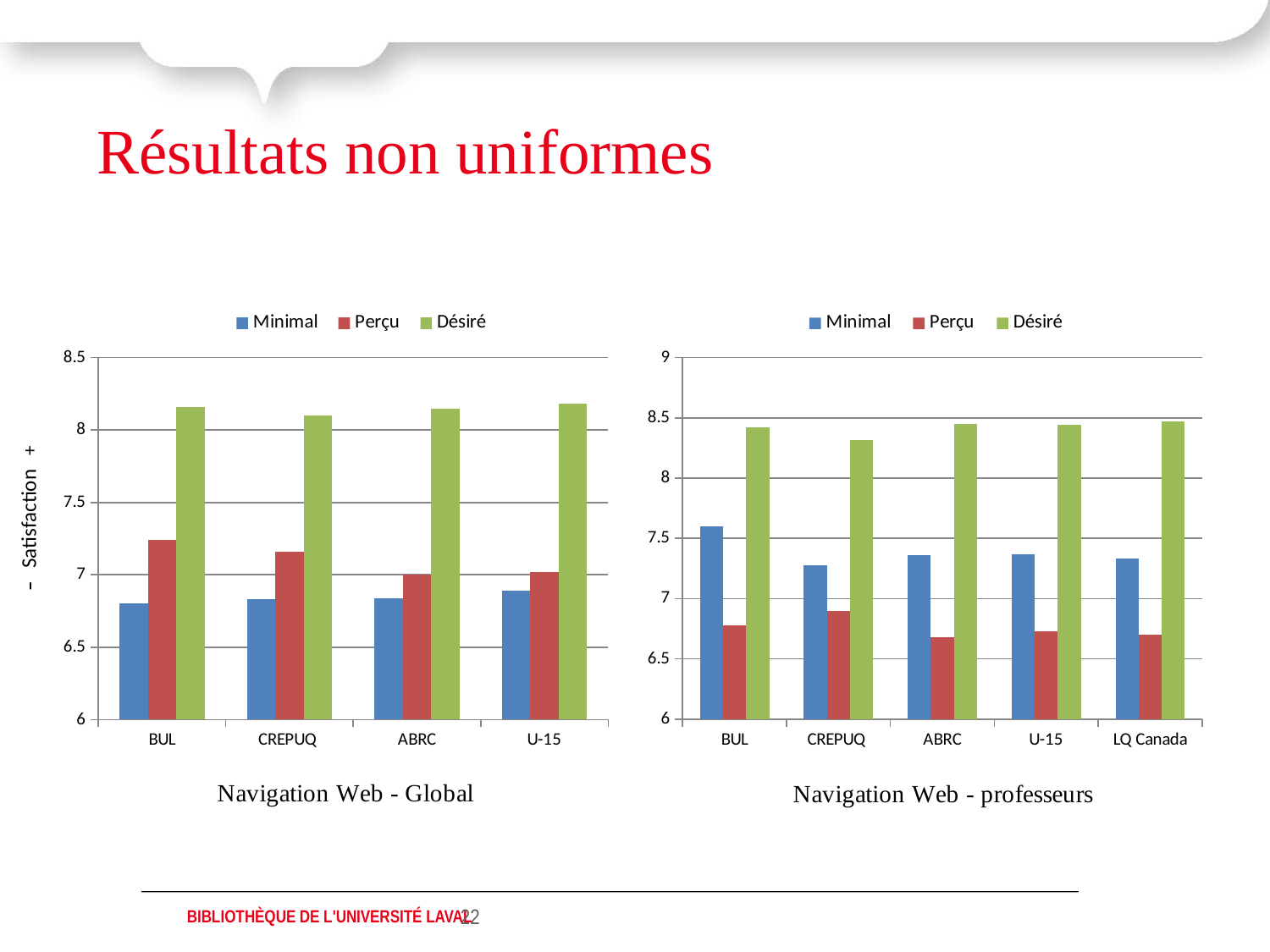
In the 'Navigation Web - professeurs' chart, for BUL, which is larger: the Minimal value or the Perçu value? Minimal In the 'Navigation Web - professeurs' chart, is the Perçu value for ABRC greater or less than 7? less How many series does the legend of the 'Navigation Web - Global' chart list? 3 In the 'Navigation Web - Global' chart, for BUL, which is larger: the Minimal value or the Perçu value? Perçu In the 'Navigation Web - Global' chart, is the Perçu value for BUL greater or less than 7? greater How many categories are shown on the x axis of the 'Navigation Web - professeurs' chart? 5 In the 'Navigation Web - Global' chart, is the Minimal value for BUL greater or less than 7? less How many categories are shown on the x axis of the 'Navigation Web - Global' chart? 4 Which category appears in the 'Navigation Web - professeurs' chart but not in the 'Navigation Web - Global' chart? LQ Canada In the 'Navigation Web - professeurs' chart, which category has the highest Minimal value? BUL What kind of chart is the 'Navigation Web - Global' chart? bar chart